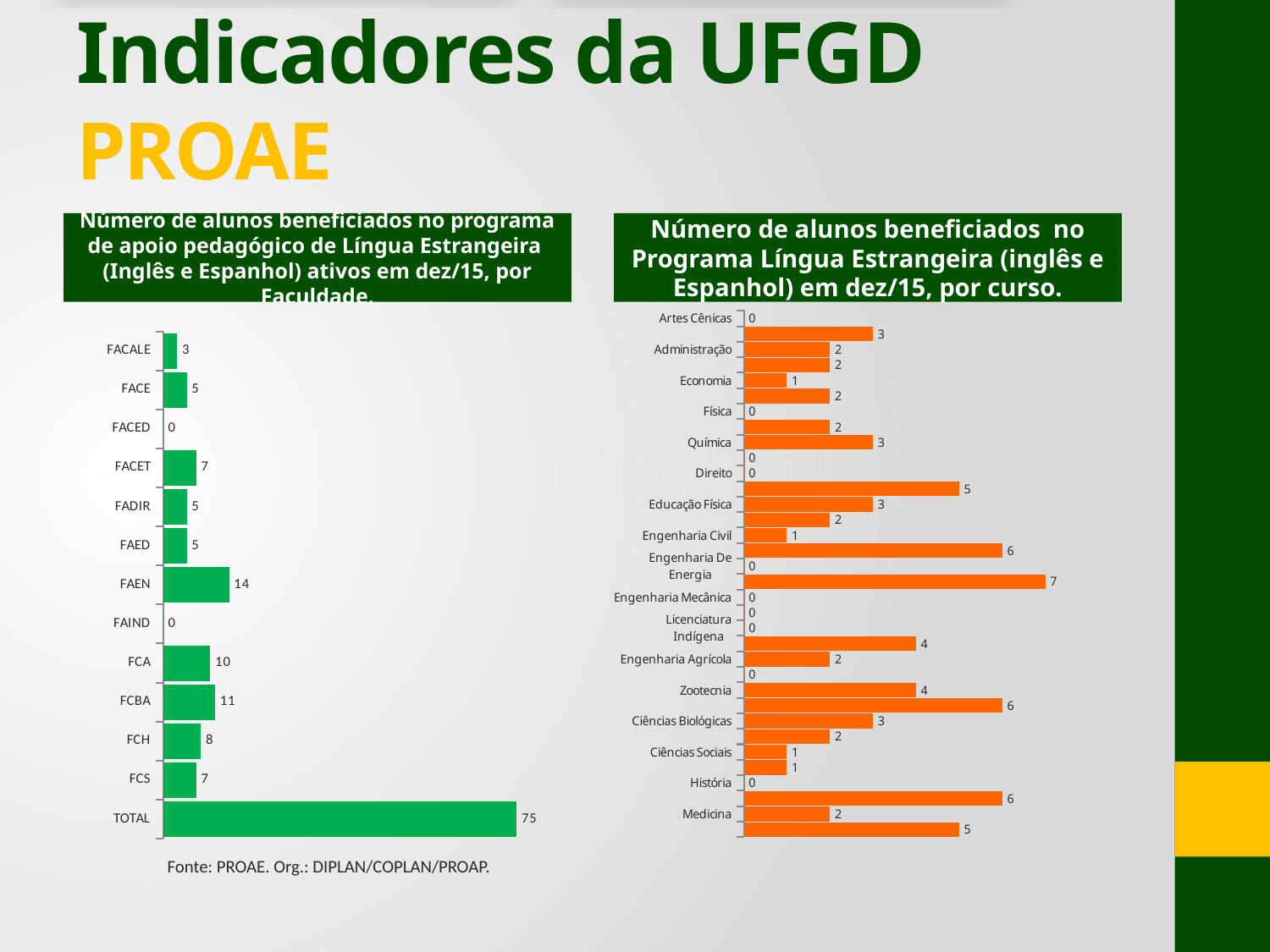
What kind of chart is the right chart (by curso)? Bar chart In the left chart (by Faculdade), what is the value for FCA? 10 In the left chart (by Faculdade), what is the difference between the values for FAEN and FCH? 6 In the left chart (by Faculdade), what is the value for TOTAL? 75 In the left chart (by Faculdade), what is the difference between the values for FCBA and FCA? 1 In the left chart (by Faculdade), what is the value for FAEN? 14 In the left chart (by Faculdade), excluding the TOTAL bar, which faculty has the highest value? FAEN In the right chart (by curso), what is the largest data label value shown? 7 What kind of chart is the left chart (by Faculdade)? Bar chart In the left chart (by Faculdade), how many faculties have a value of 0? 2 In the left chart (by Faculdade), which has a larger value, FCH or FCS? FCH In the left chart (by Faculdade), how many bars are plotted, including TOTAL? 13